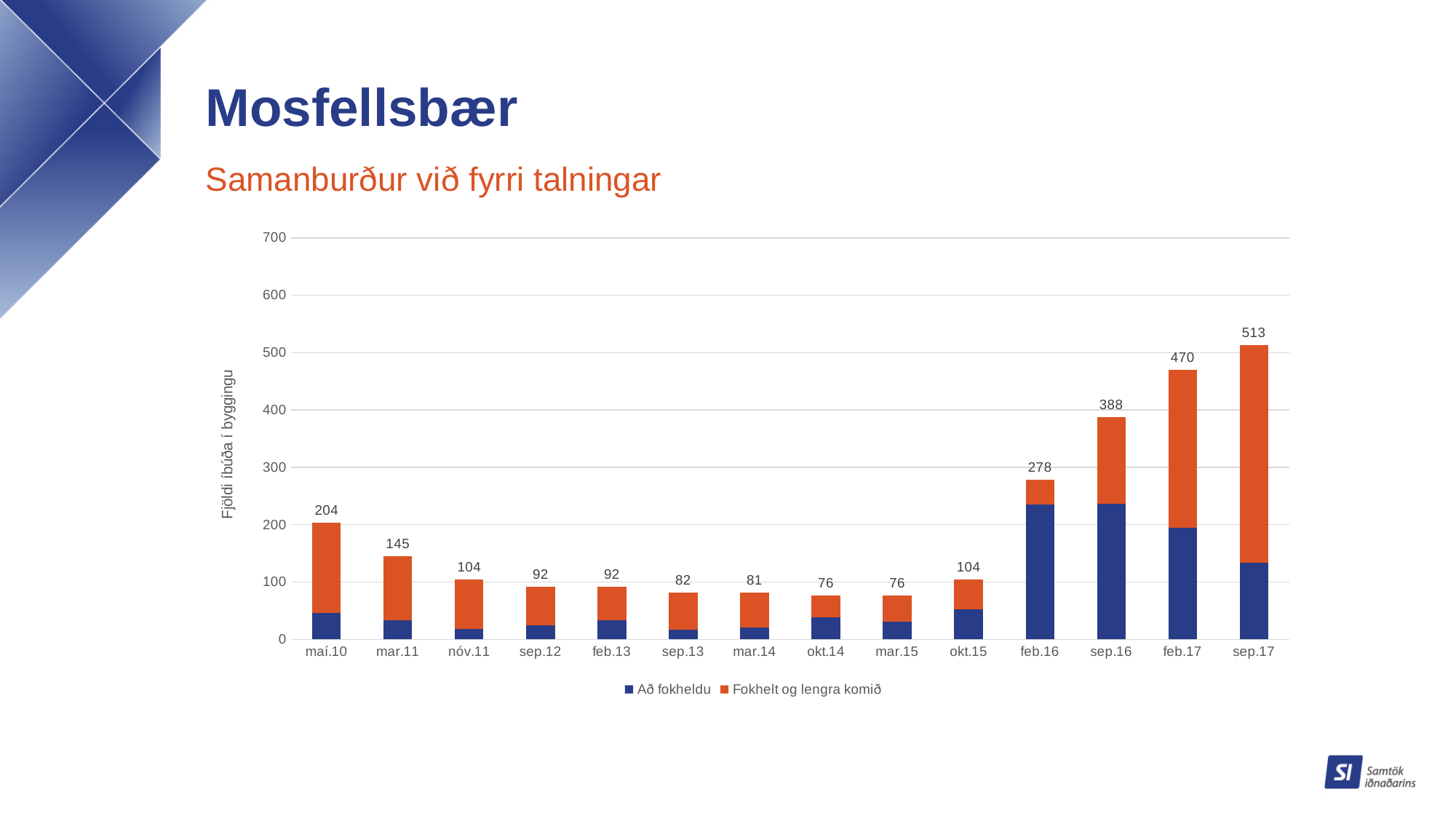
Which has a larger total, mar.11 or okt.15? mar.11 How many categories are shown on the x axis? 14 What is the total value shown for maí.10? 204 Which category has the highest total? sep.17 What is the total value shown for feb.16? 278 What is the total value shown for sep.17? 513 Is the value of the Að fokheldu segment for feb.16 greater or less than 200? greater What is the difference between the totals for sep.17 and feb.17? 43 What is the difference between the totals for sep.16 and feb.16? 110 What kind of chart is shown on the slide? Stacked bar chart How many series does the legend list? 2 Do the totals rise or fall from okt.15 to sep.17? Rise